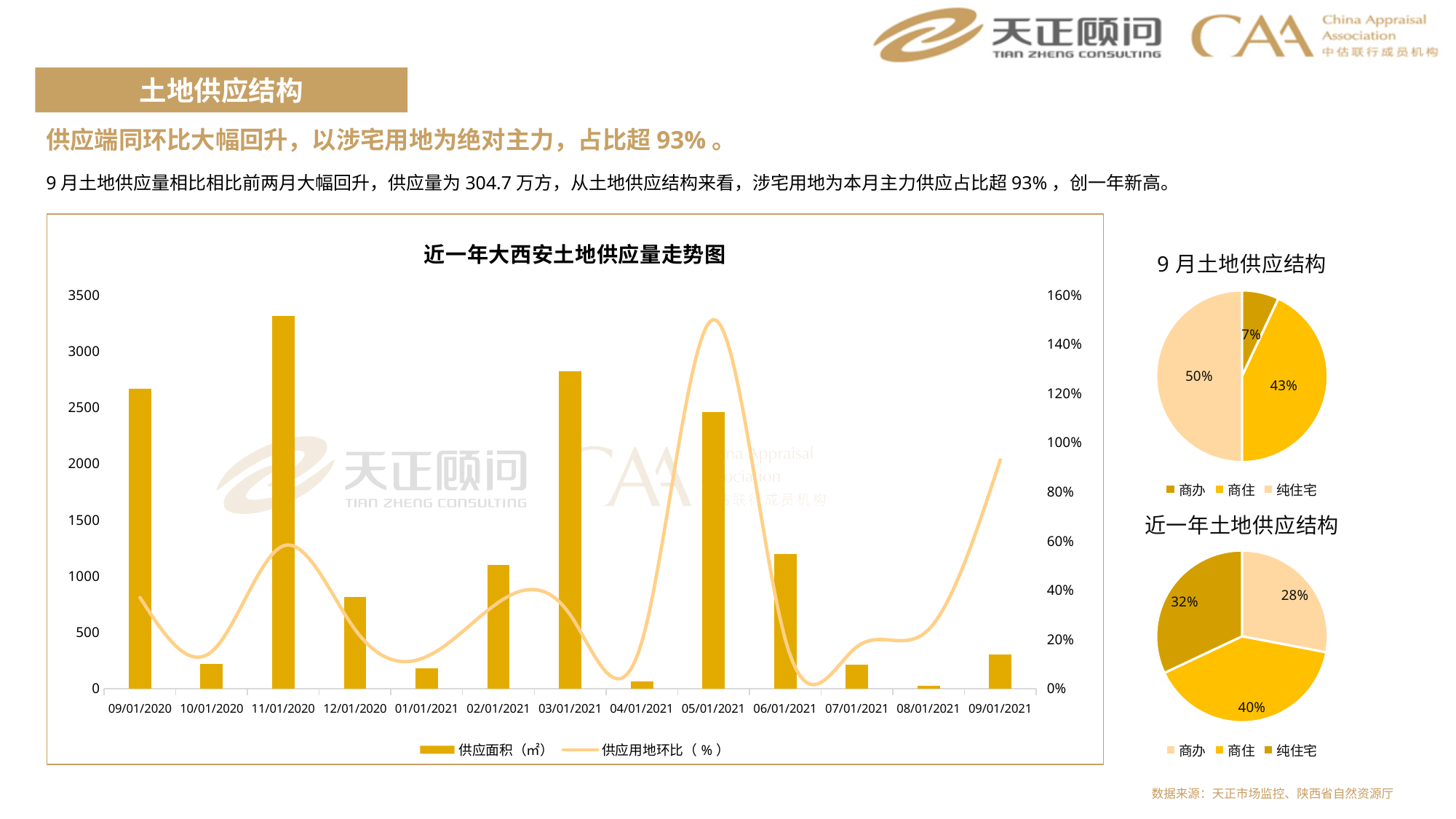
In the chart titled 近一年大西安土地供应量走势图, is the 供应面积 value for 09/01/2020 greater or less than 2500? greater In the chart titled 近一年大西安土地供应量走势图, how many months are shown on the x axis? 13 In the pie chart titled 近一年土地供应结构, what is the difference between the shares of 商住 and 纯住宅? 8% In the pie chart titled 近一年土地供应结构, what share does 商办 have? 28% In the chart titled 近一年大西安土地供应量走势图, is the 供应面积 value for 12/01/2020 greater or less than 1000? less In the chart titled 近一年大西安土地供应量走势图, which month has the highest 供应面积 bar? 11/01/2020 In the chart titled 近一年大西安土地供应量走势图, which month has the lowest 供应面积 bar? 08/01/2021 In the pie chart titled 近一年土地供应结构, which category has the largest share? 商住 In the chart titled 近一年大西安土地供应量走势图, how many series does the legend list? 2 In the pie chart titled 9月土地供应结构, what share does 商住 have? 43% In the pie chart titled 9月土地供应结构, what share does 纯住宅 have? 50% In the pie chart titled 9月土地供应结构, which category has the smallest share? 商办